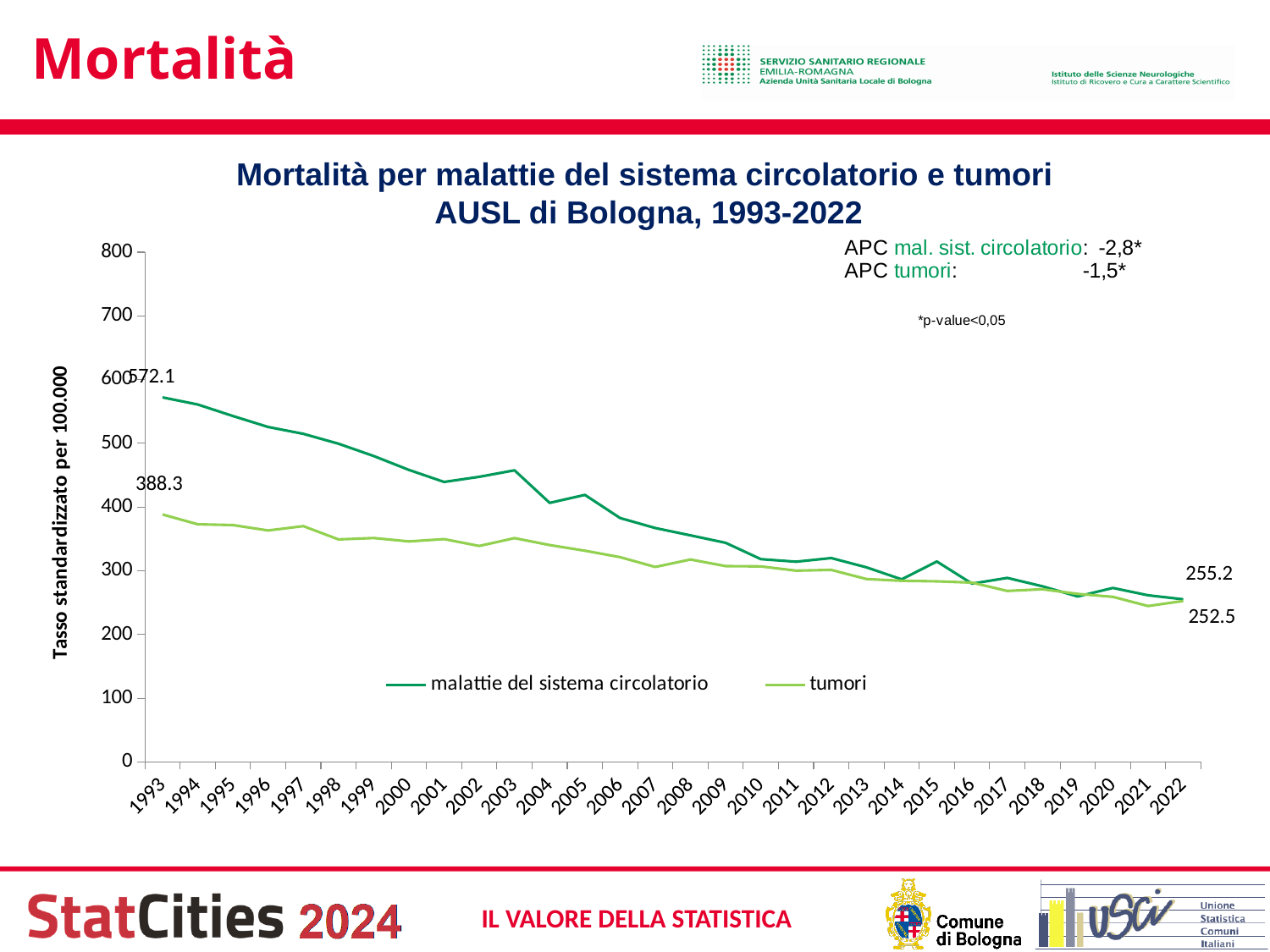
By how much did the value for malattie del sistema circolatorio fall between 1993 and 2022? 316.9 Is the value for malattie del sistema circolatorio in 2003 greater or less than 400? greater What is the value for malattie del sistema circolatorio in 2022? 255.2 In which year is the value for malattie del sistema circolatorio highest? 1993 What is the difference between the malattie del sistema circolatorio and tumori values in 1993? 183.8 What is the value for malattie del sistema circolatorio in 1993? 572.1 What is the value for tumori in 1993? 388.3 What is the value for tumori in 2022? 252.5 How many years are plotted on the x axis? 30 What kind of chart is shown? line chart How many series does the legend list? 2 In 1993, which series has the higher value: malattie del sistema circolatorio or tumori? malattie del sistema circolatorio